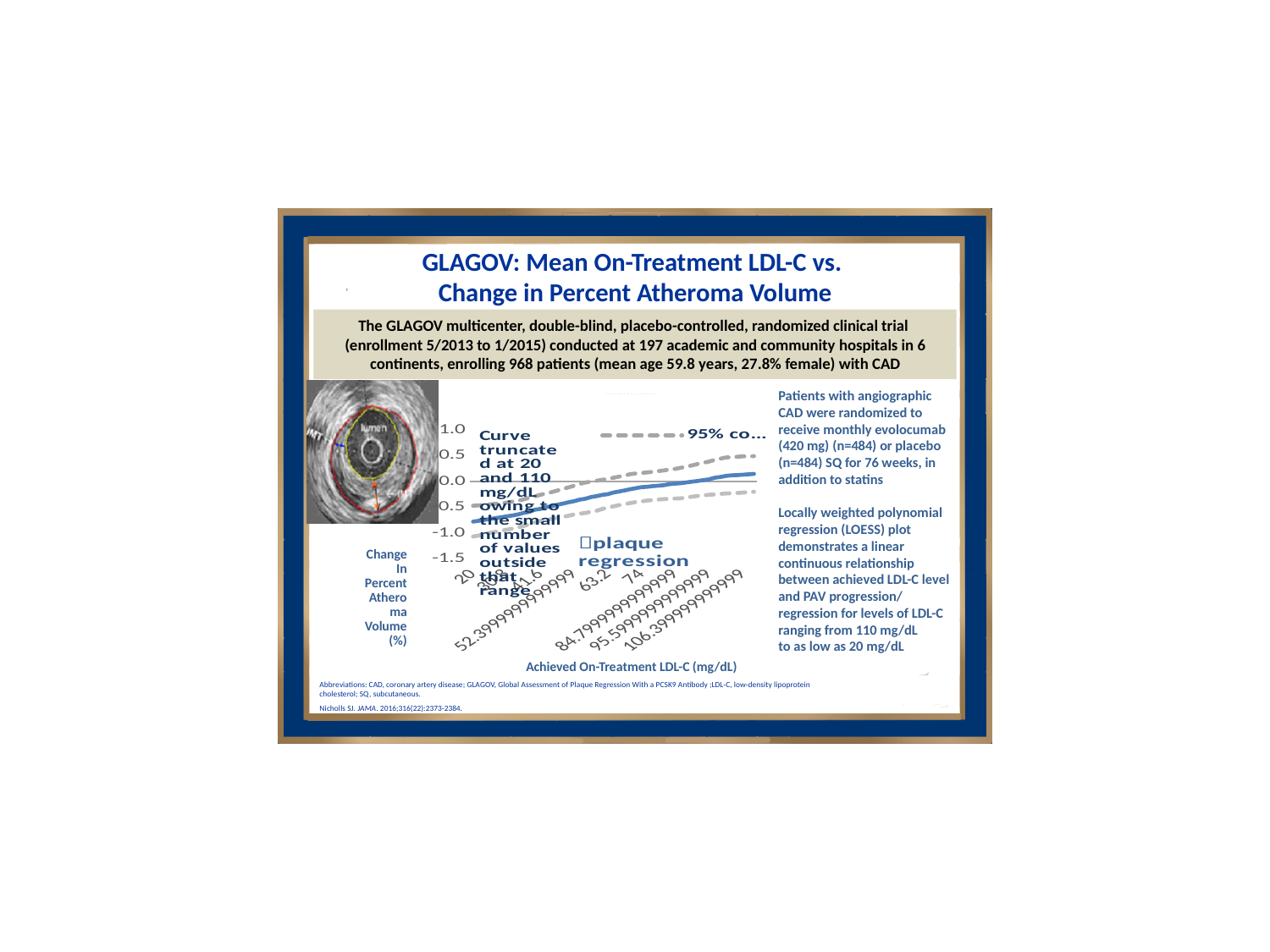
Is the value of the solid blue line at an LDL-C of 20 mg/dL greater or less than -1.0? greater Is the value of the solid blue line at an LDL-C of 20 mg/dL greater or less than 0.0? less What is the highest tick value shown on the y axis of the chart? 1.0 Does the solid blue line rise or fall as achieved on-treatment LDL-C increases along the x axis? rises What kind of chart is shown on the slide? line chart What is the lowest tick value shown on the y axis of the chart? -1.5 What is the title of the x axis of the chart? Achieved On-Treatment LDL-C (mg/dL)